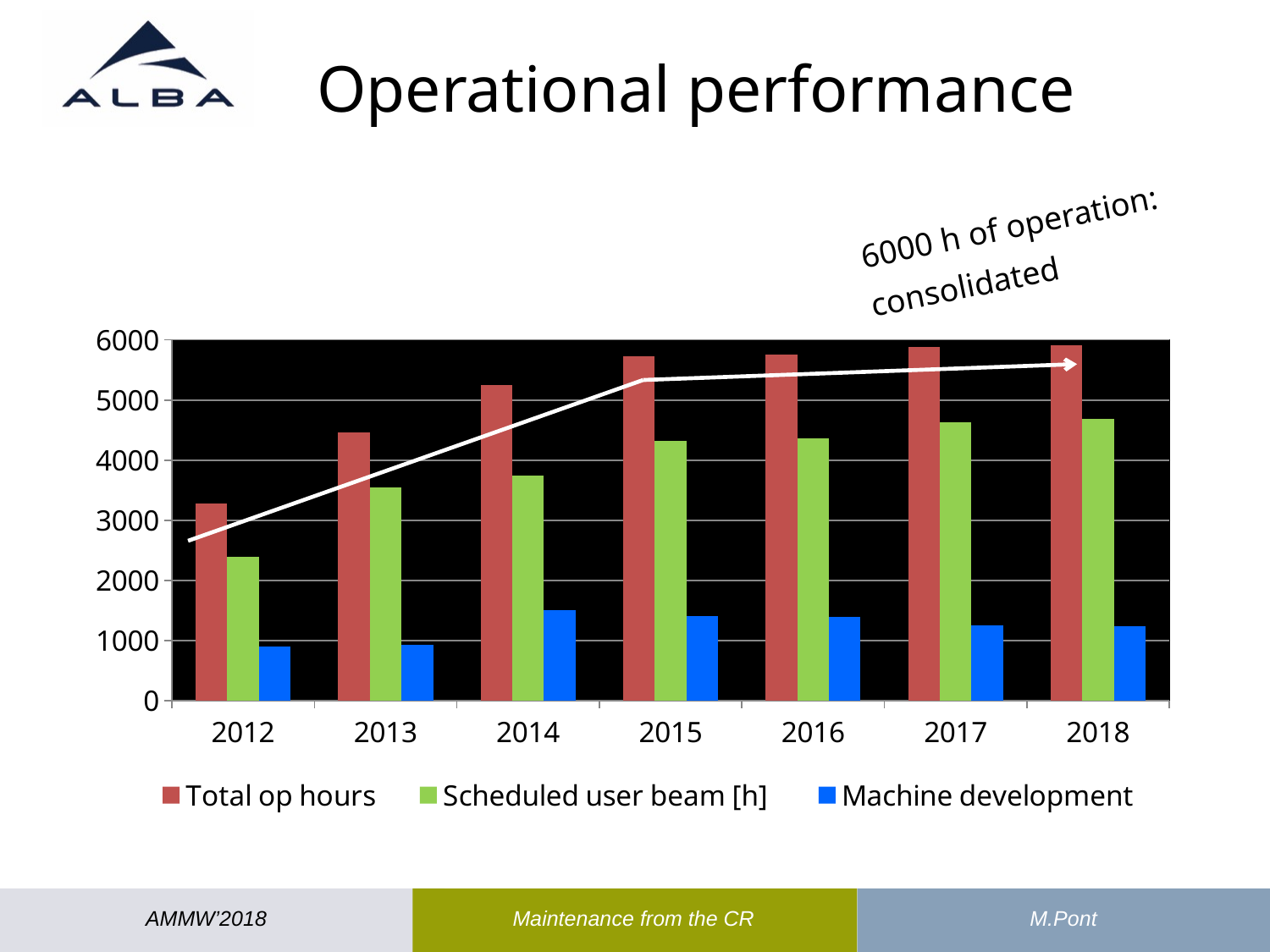
Which year has the lowest Total op hours? 2012 Is the Machine development value for 2012 greater or less than 1000? less How many years are shown on the x axis? 7 Do the Total op hours generally rise or fall from 2012 to 2018? rise Which year has the lowest Scheduled user beam [h]? 2012 Is the Total op hours value for 2012 greater or less than 3000? greater Which year has the highest Machine development value? 2014 Is the Scheduled user beam [h] value for 2018 greater or less than 5000? less What kind of chart is shown on the slide? bar chart Which year has the larger Scheduled user beam [h] value, 2013 or 2015? 2015 How many series does the legend list? 3